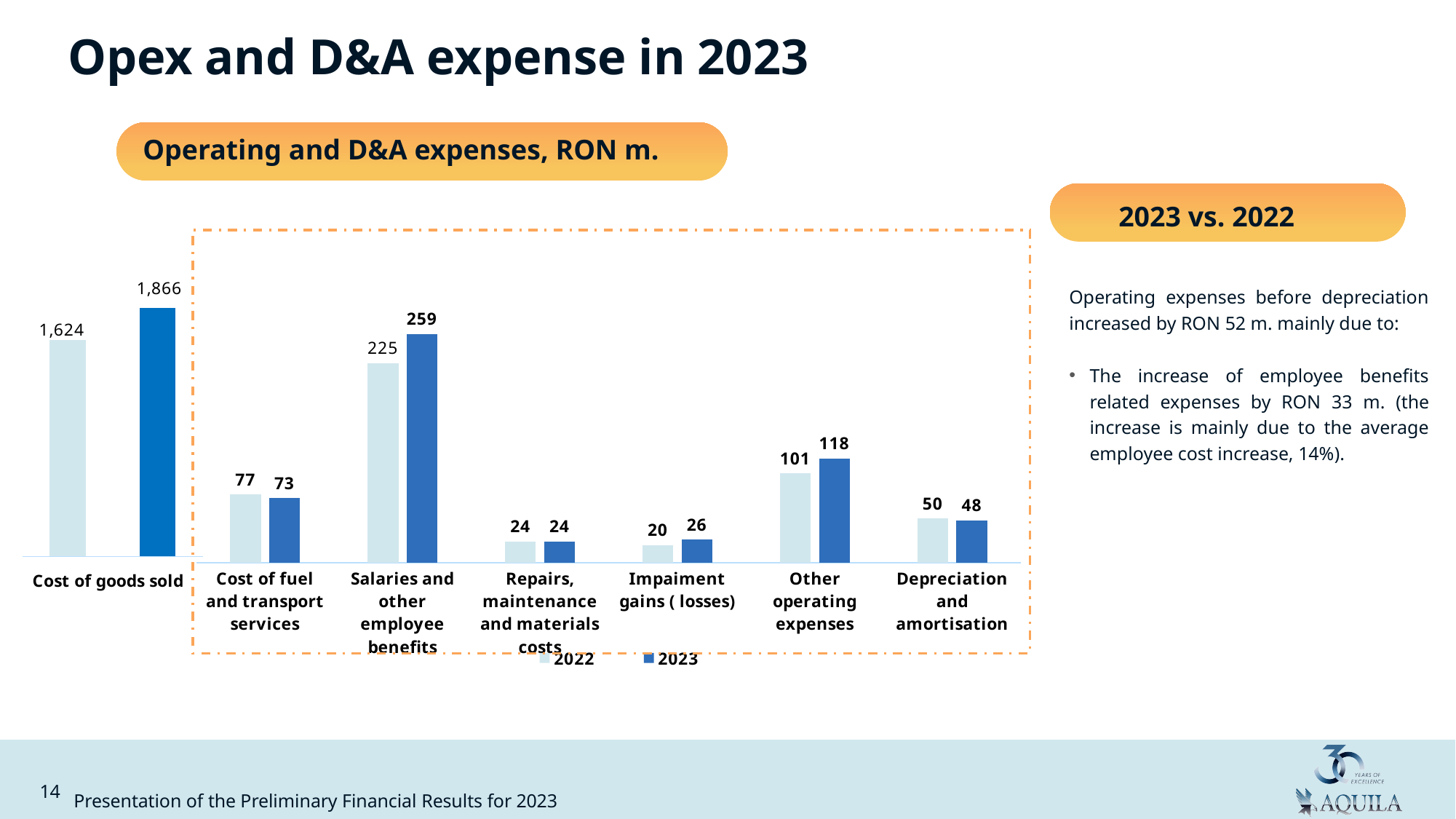
What is the 2023 value for Cost of goods sold? 1,866 What is the 2022 value for Salaries and other employee benefits? 225 What is the difference between the 2023 and 2022 values for Salaries and other employee benefits? 34 Which category has the lowest 2022 value? Impaiment gains ( losses) What is the 2022 value for Depreciation and amortisation? 50 What type of chart is shown on the slide? Bar chart Which category has the highest 2023 value? Cost of goods sold How many series does the legend list? 2 What is the difference between the 2023 and 2022 values for Cost of goods sold? 242 How many categories are shown on the x axis of the chart? 7 What is the 2023 value for Other operating expenses? 118 Which is larger for Cost of fuel and transport services, the 2022 value or the 2023 value? 2022